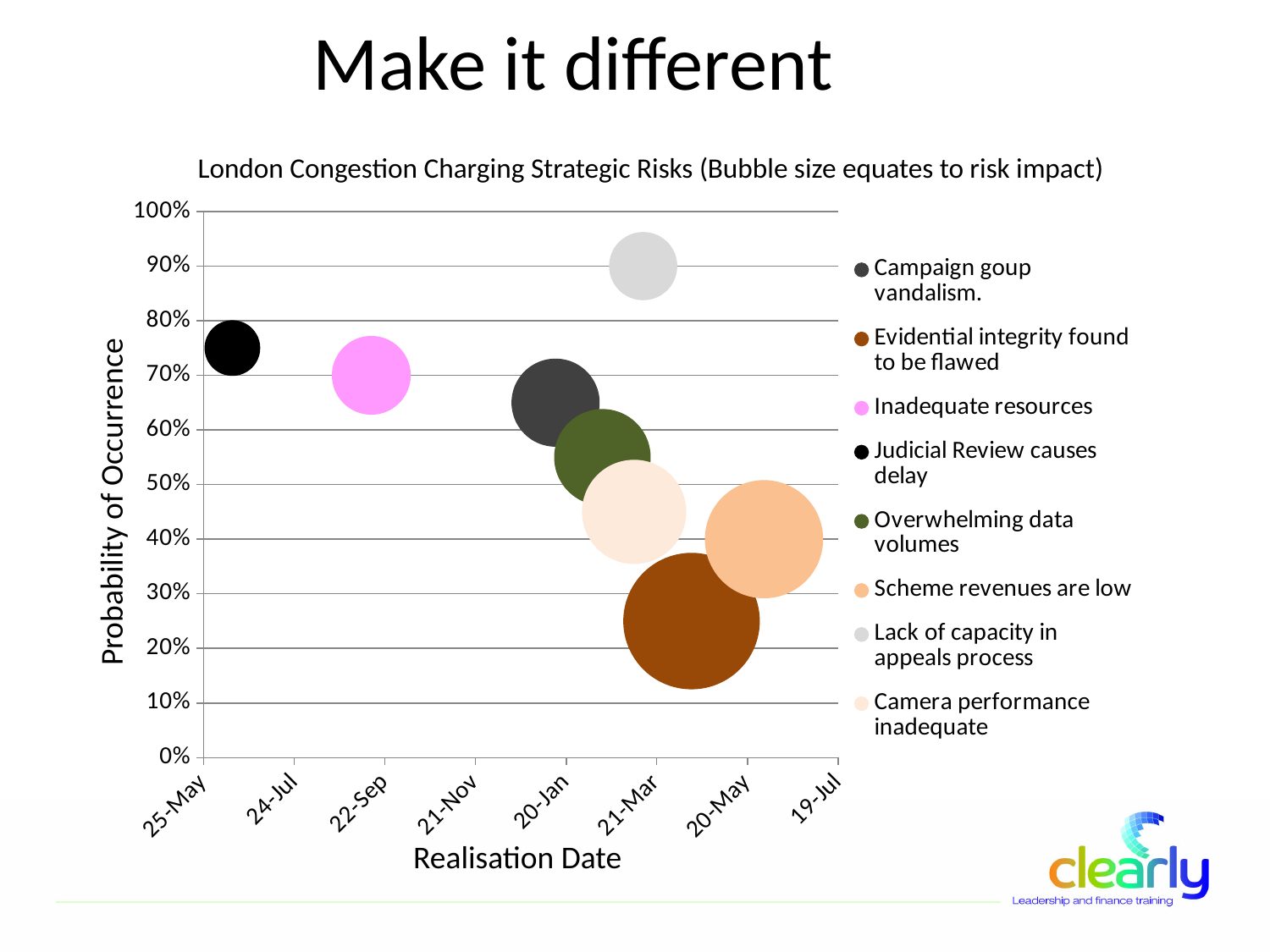
Which has a higher probability of occurrence: 'Inadequate resources' or 'Camera performance inadequate'? Inadequate resources Which risk has the lowest probability of occurrence? Evidential integrity found to be flawed Which risk has the highest probability of occurrence? Lack of capacity in appeals process Is the probability of occurrence for 'Scheme revenues are low' greater or less than 60%? less Is the probability of occurrence for 'Lack of capacity in appeals process' greater or less than 80%? greater Which risk has the earliest realisation date? Judicial Review causes delay What is the title of the chart? London Congestion Charging Strategic Risks (Bubble size equates to risk impact) How many risks does the legend list? 8 Is the probability of occurrence for 'Judicial Review causes delay' greater or less than 60%? greater Which risk has the largest bubble, indicating the greatest risk impact? Evidential integrity found to be flawed What kind of chart is shown on the slide? Bubble chart